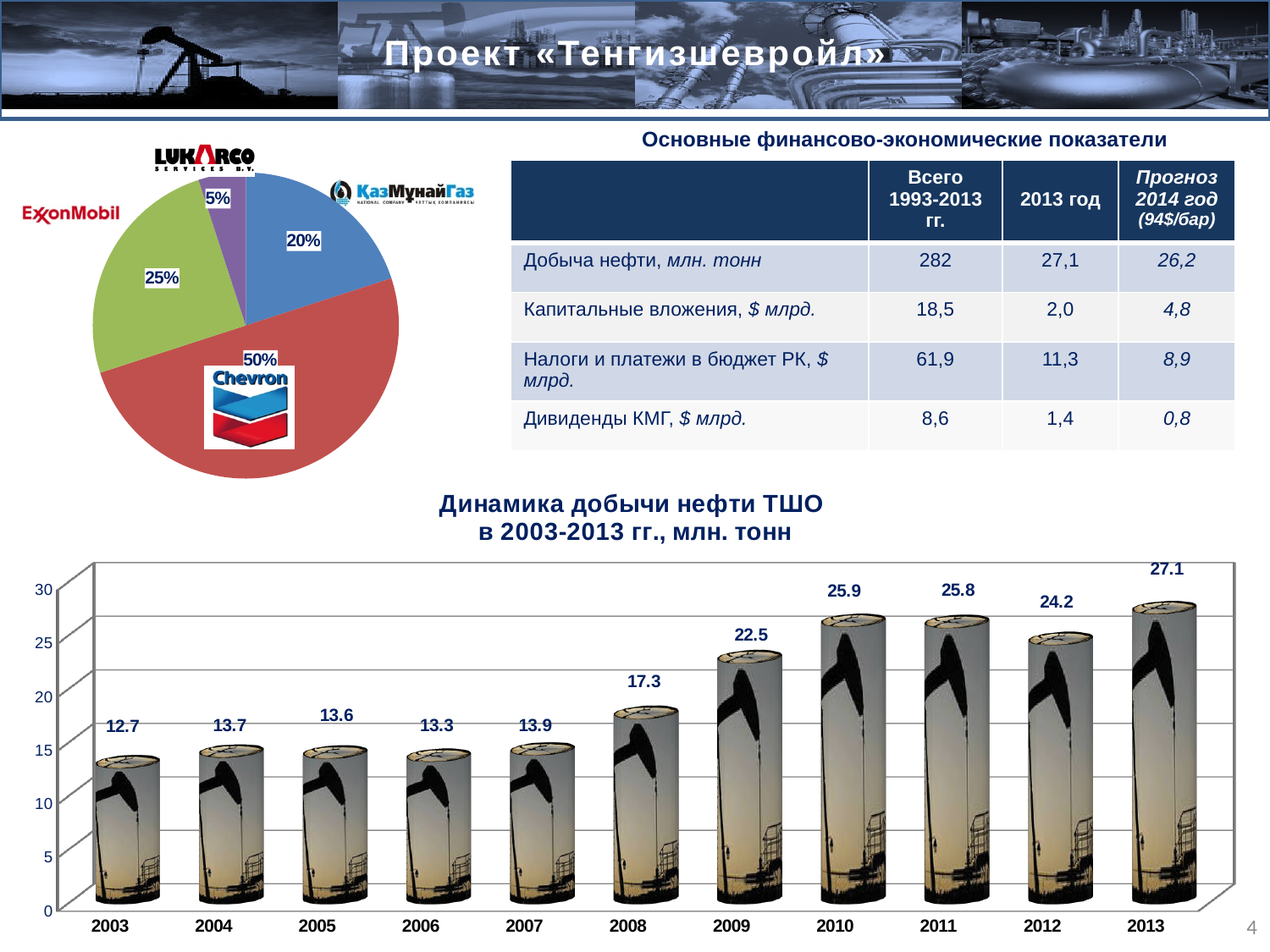
In the pie chart, which company has the smallest share? LukArco In the pie chart, what is the difference between the Chevron share and the KazMunayGas share? 30% In the pie chart, how many slices are there? 4 In the chart 'Динамика добычи нефти ТШО в 2003-2013 гг., млн. тонн', what was the value for 2009? 22.5 In the pie chart, what share does ExxonMobil hold? 25% In the pie chart, what share does Chevron hold? 50% In the chart 'Динамика добычи нефти ТШО в 2003-2013 гг., млн. тонн', which year has the lowest value? 2003 What kind of chart is the chart 'Динамика добычи нефти ТШО в 2003-2013 гг., млн. тонн'? Bar chart In the chart 'Динамика добычи нефти ТШО в 2003-2013 гг., млн. тонн', what is the difference between the 2013 and 2003 values? 14.4 In the chart 'Динамика добычи нефти ТШО в 2003-2013 гг., млн. тонн', which year has the highest value? 2013 In the chart 'Динамика добычи нефти ТШО в 2003-2013 гг., млн. тонн', which is larger, the value for 2010 or the value for 2012? 2010 In the chart 'Динамика добычи нефти ТШО в 2003-2013 гг., млн. тонн', how many years are shown? 11